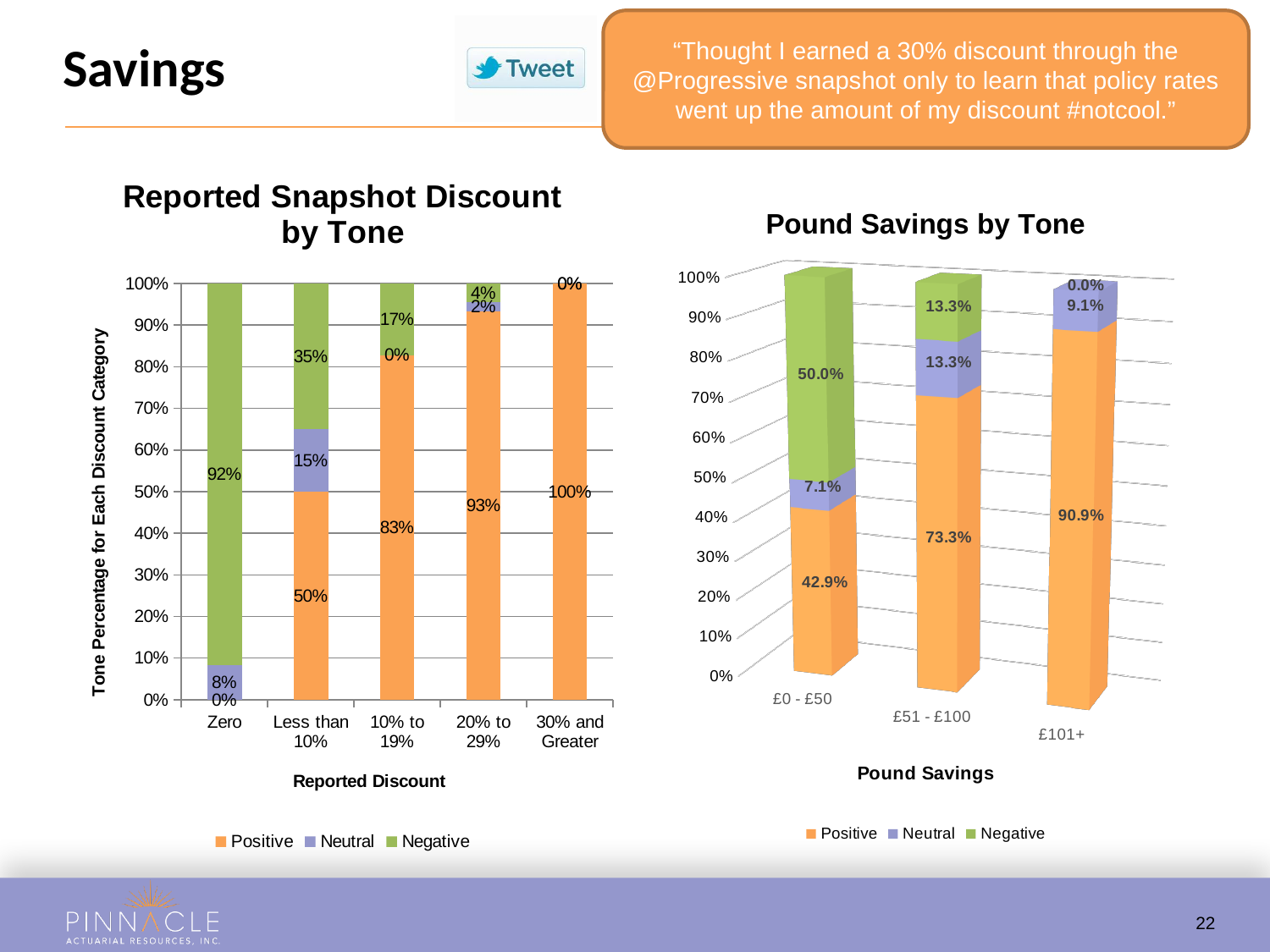
In the "Reported Snapshot Discount by Tone" chart, what is the difference between the Positive percentages for the 10% to 19% and Less than 10% categories? 33% In the "Pound Savings by Tone" chart, which category has the lowest Positive percentage? £0 - £50 What kind of chart is "Pound Savings by Tone"? Stacked bar chart In the "Reported Snapshot Discount by Tone" chart, which discount category has the highest Positive percentage? 30% and Greater In the "Reported Snapshot Discount by Tone" chart, how many discount categories are shown on the x axis? 5 In the "Pound Savings by Tone" chart, what is the Negative percentage for the £0 - £50 category? 50.0% In the "Reported Snapshot Discount by Tone" chart, what is the Neutral percentage for the 20% to 29% category? 2% In the "Pound Savings by Tone" chart, is the Positive percentage larger for £101+ or for £51 - £100? £101+ In the "Pound Savings by Tone" chart, how many series does the legend list? 3 In the "Pound Savings by Tone" chart, what is the Positive percentage for the £51 - £100 category? 73.3% In the "Reported Snapshot Discount by Tone" chart, what is the Positive percentage for the Less than 10% category? 50% In the "Reported Snapshot Discount by Tone" chart, what is the Negative percentage for the Zero discount category? 92%